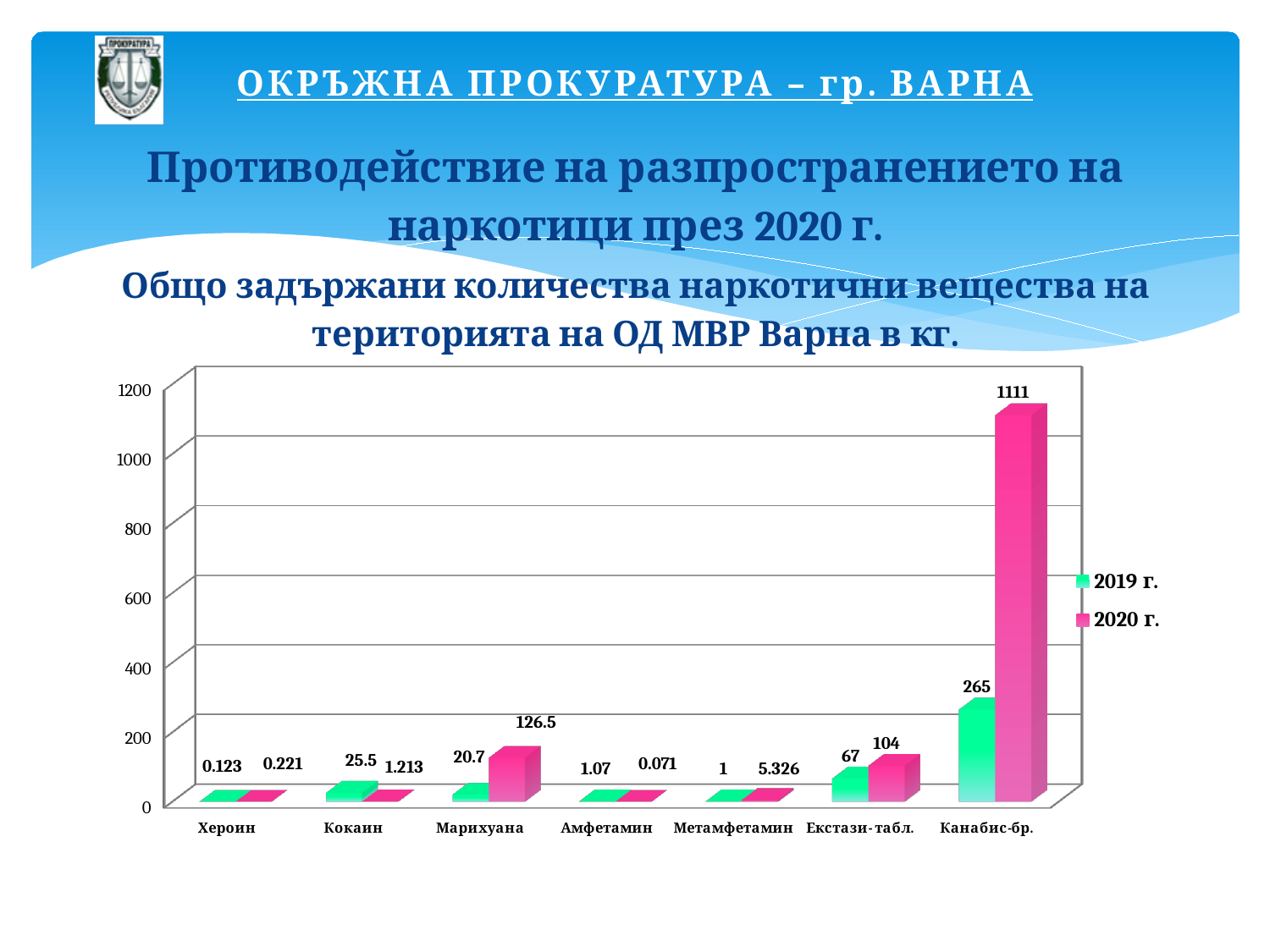
What is the 2020 г. value for Марихуана? 126.5 How many series does the legend list? 2 Which category has the highest 2020 г. value? Канабис-бр. What is the difference between the 2020 г. and 2019 г. values for Екстази-табл.? 37 How many categories are shown on the x axis? 7 Which is larger for Кокаин: the 2019 г. value or the 2020 г. value? 2019 г. What kind of chart is shown on the slide? Bar chart What is the 2020 г. value for Канабис-бр.? 1111 What is the 2020 г. value for Метамфетамин? 5.326 What is the 2019 г. value for Екстази-табл.? 67 Which category has the lowest 2019 г. value? Хероин What is the 2019 г. value for Кокаин? 25.5